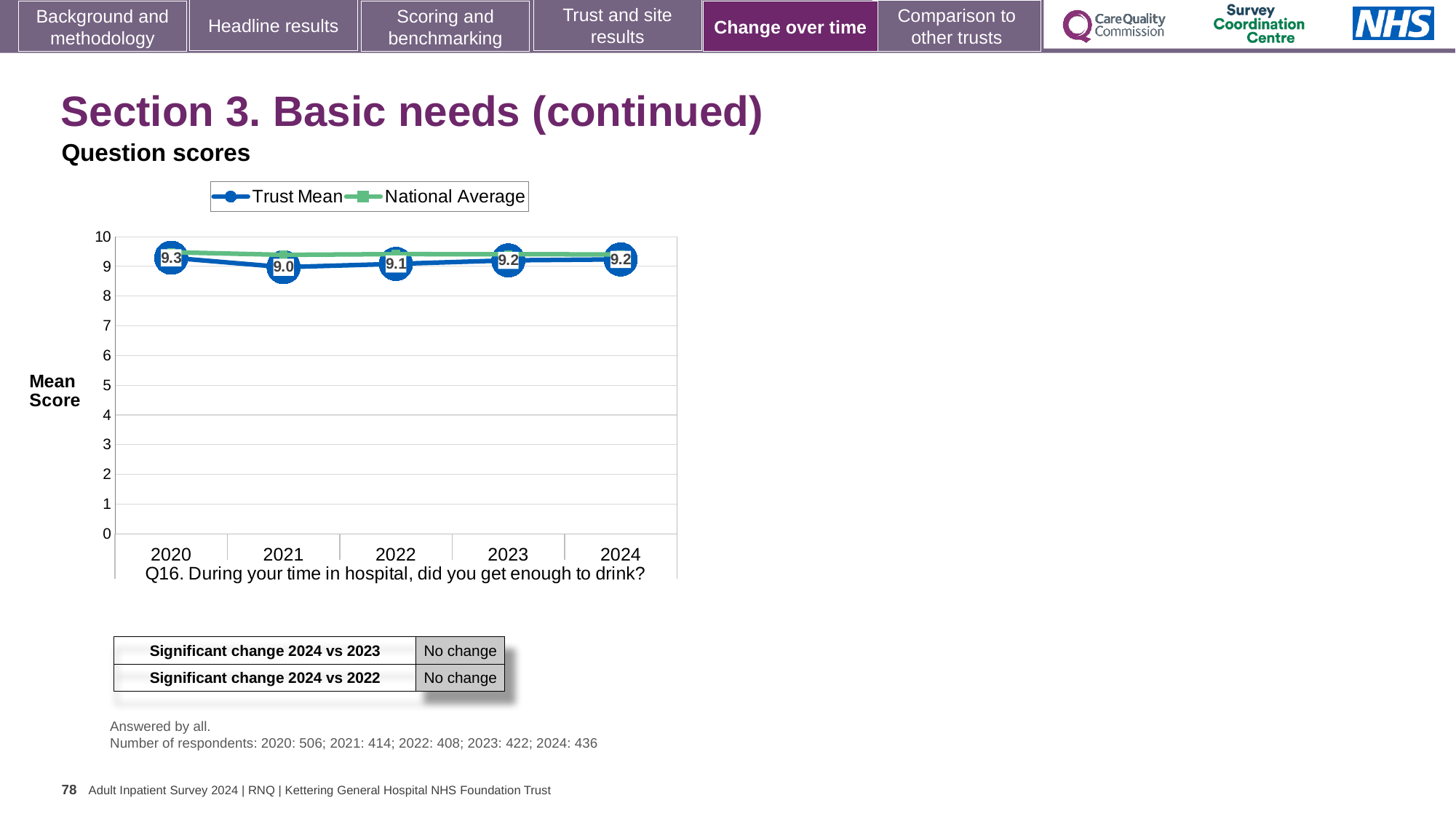
Is the National Average value for 2022 greater or less than 8? greater Does the Trust Mean score rise or fall from 2021 to 2023? Rise How many series does the chart legend list? 2 What is the Trust Mean score for 2024? 9.2 How many years are shown on the x axis of the chart? 5 What is the Trust Mean score for 2020? 9.3 What kind of chart is shown on the slide? Line chart In which year is the Trust Mean score lowest? 2021 What is the Trust Mean score for 2021? 9.0 What is the difference between the Trust Mean scores for 2020 and 2021? 0.3 Which year has the larger Trust Mean score, 2021 or 2023? 2023 In which year is the Trust Mean score highest? 2020